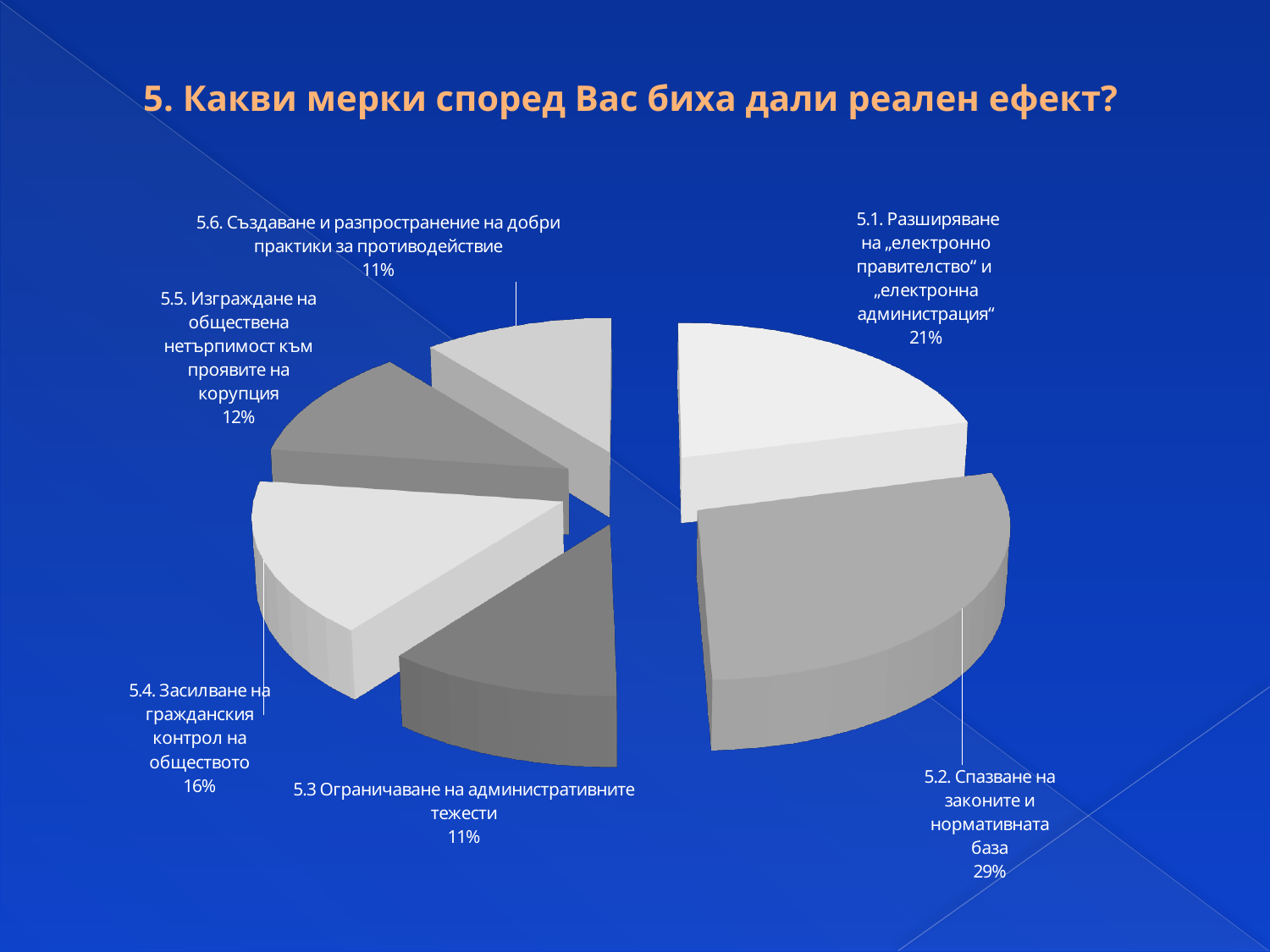
How many slices does the pie chart have? 6 What kind of chart is shown on the slide? Pie chart What percentage is shown for "5.5. Изграждане на обществена нетърпимост към проявите на корупция"? 12% What percentage is shown for "5.2. Спазване на законите и нормативната база"? 29% Which measure has the largest share of the pie? 5.2. Спазване на законите и нормативната база What is the difference in percentage points between the share for 5.2 (Спазване на законите и нормативната база) and the share for 5.1 (Разширяване на „електронно правителство“)? 8 percentage points What share of the pie does "5.6. Създаване и разпространение на добри практики за противодействие" represent? 11% What percentage is shown for "5.3 Ограничаване на административните тежести"? 11% What is the title of the slide containing the chart? 5. Какви мерки според Вас биха дали реален ефект? What percentage is shown for "5.4. Засилване на гражданския контрол на обществото"? 16% What percentage is shown for "5.1. Разширяване на „електронно правителство“ и „електронна администрация“"? 21% Which has a larger share: 5.1 (Разширяване на „електронно правителство“) or 5.4 (Засилване на гражданския контрол на обществото)? 5.1 (Разширяване на „електронно правителство“)